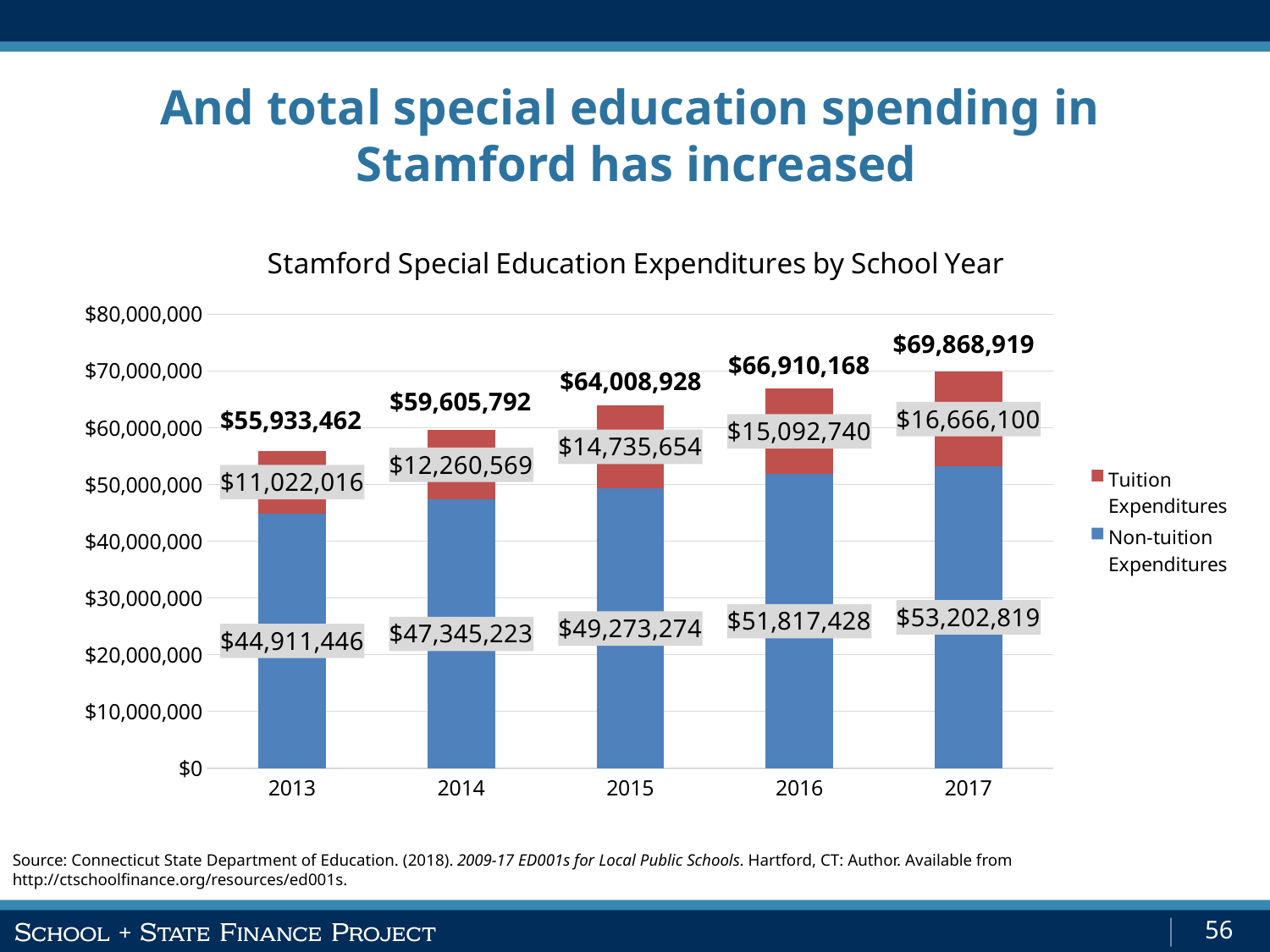
What type of chart is shown on the slide? Stacked bar chart Which is larger: Non-tuition Expenditures in 2016 or in 2015? 2016 Which school year has the highest total special education expenditure? 2017 How much higher were Tuition Expenditures in 2017 than in 2013? $5,644,084 Which school year has the lowest Tuition Expenditures? 2013 How many series does the legend list? 2 What is the total special education expenditure shown for 2016? $66,910,168 What were Non-tuition Expenditures in 2014? $47,345,223 How many school years are shown on the x axis? 5 What were Tuition Expenditures in 2015? $14,735,654 Do total special education expenditures rise or fall from 2013 to 2017? Rise What is the title of the chart? Stamford Special Education Expenditures by School Year